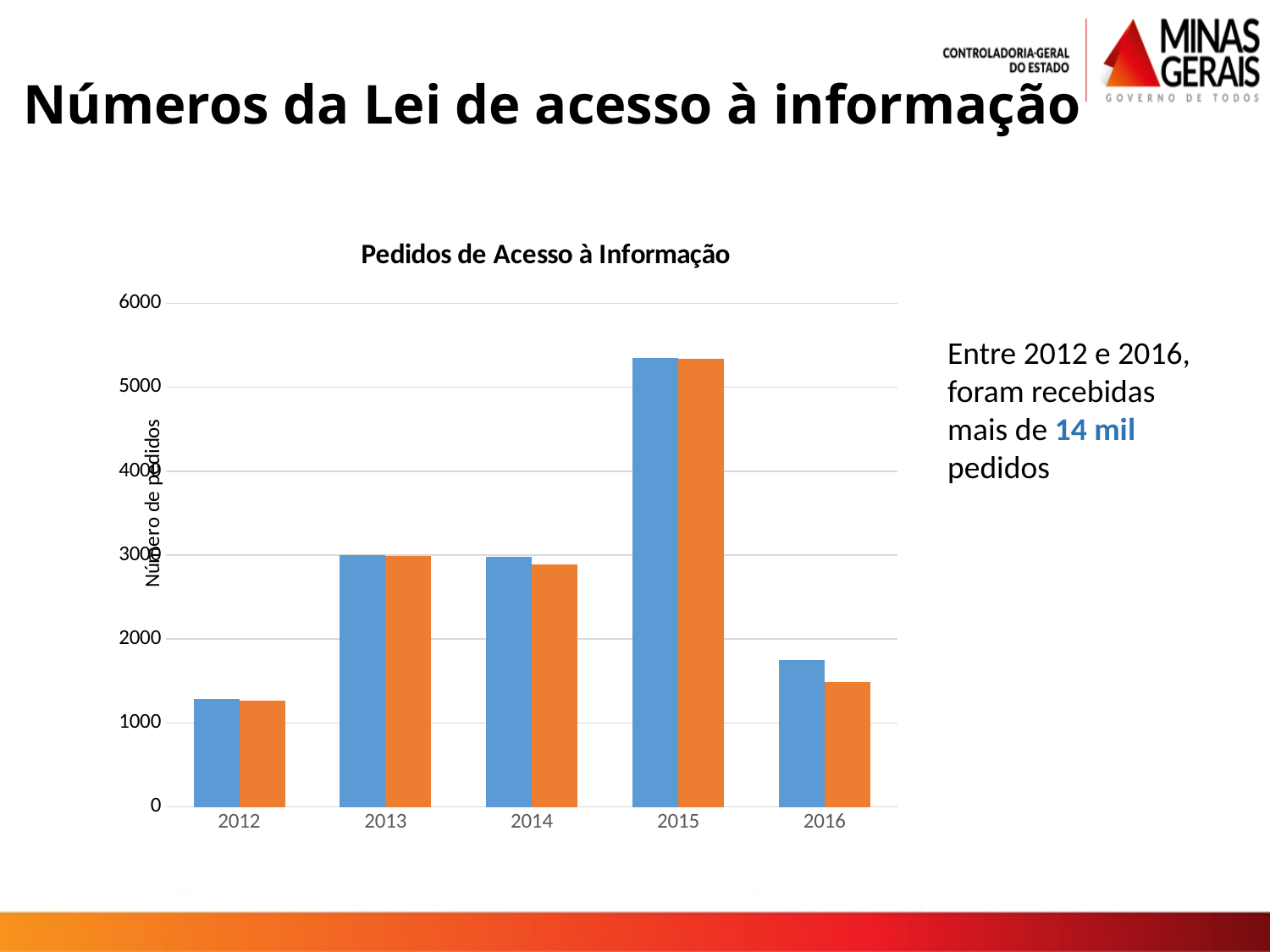
What type of chart is shown on the slide? bar chart How many years are shown on the x axis of the chart? 5 What is the title of the chart? Pedidos de Acesso à Informação Which year has the highest bars in the chart? 2015 What is the label of the vertical axis of the chart? Número de pedidos Which year has the larger blue bar, 2013 or 2015? 2015 Is the value of the orange bar for 2016 greater or less than 2000? less Is the value of the blue bar for 2012 greater or less than 2000? less Is the value of the blue bar for 2015 greater or less than 5000? greater Which year has the lowest bars in the chart? 2012 Which year has the larger blue bar, 2012 or 2016? 2016